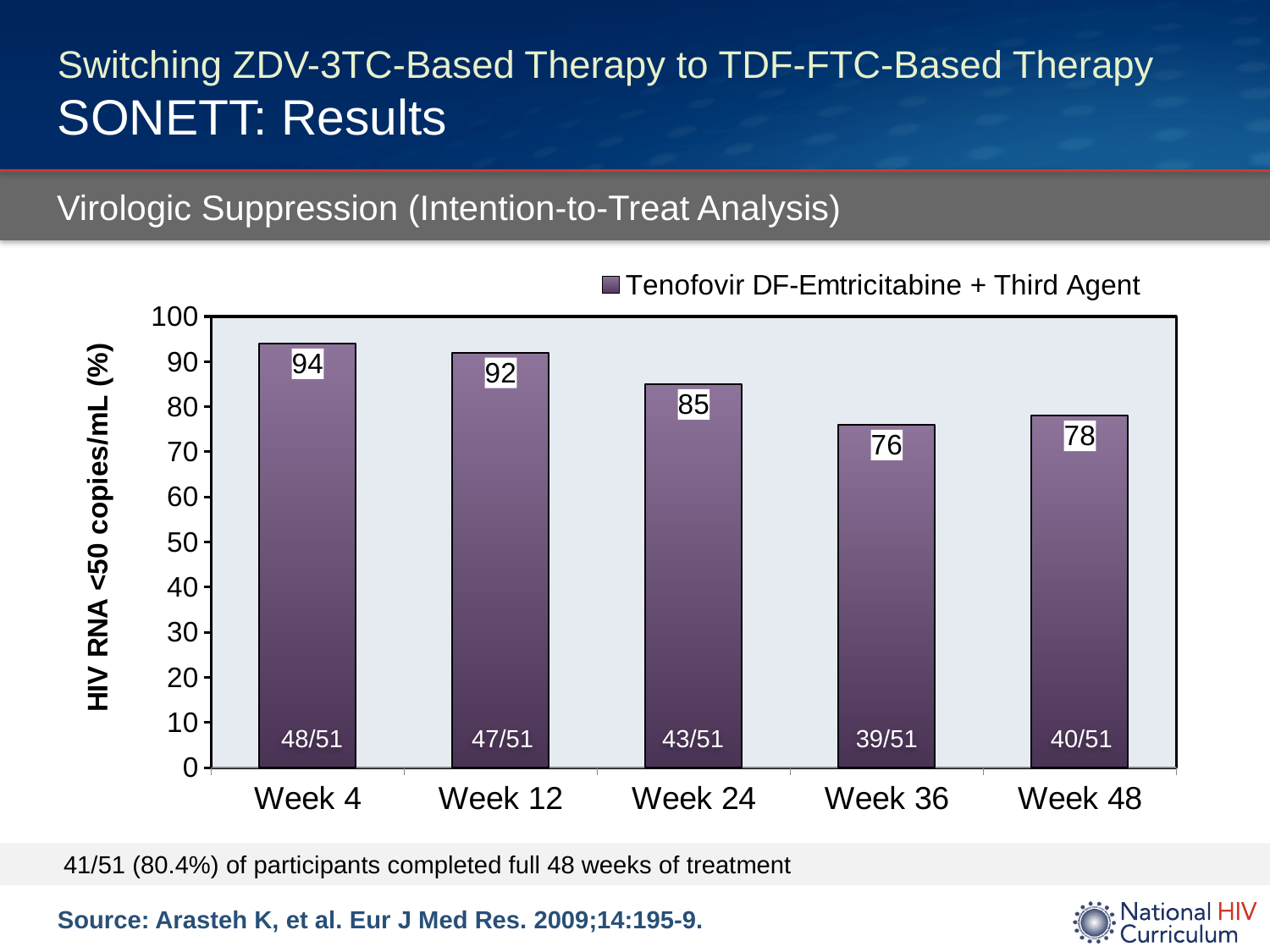
Which is larger, the value for Week 12 or the value for Week 24? Week 12 How many weeks (categories) are shown on the x axis? 5 What is the value for Week 48? 78 What is the fraction label shown inside the Week 24 bar? 43/51 Which week has the lowest value? Week 36 How many series does the legend list? 1 What is the value for Week 4? 94 What kind of chart is shown? Bar chart Is the value for Week 24 greater or less than 80? greater Which week has the highest value? Week 4 What is the difference between the values for Week 4 and Week 48? 16 What is the value for Week 36? 76